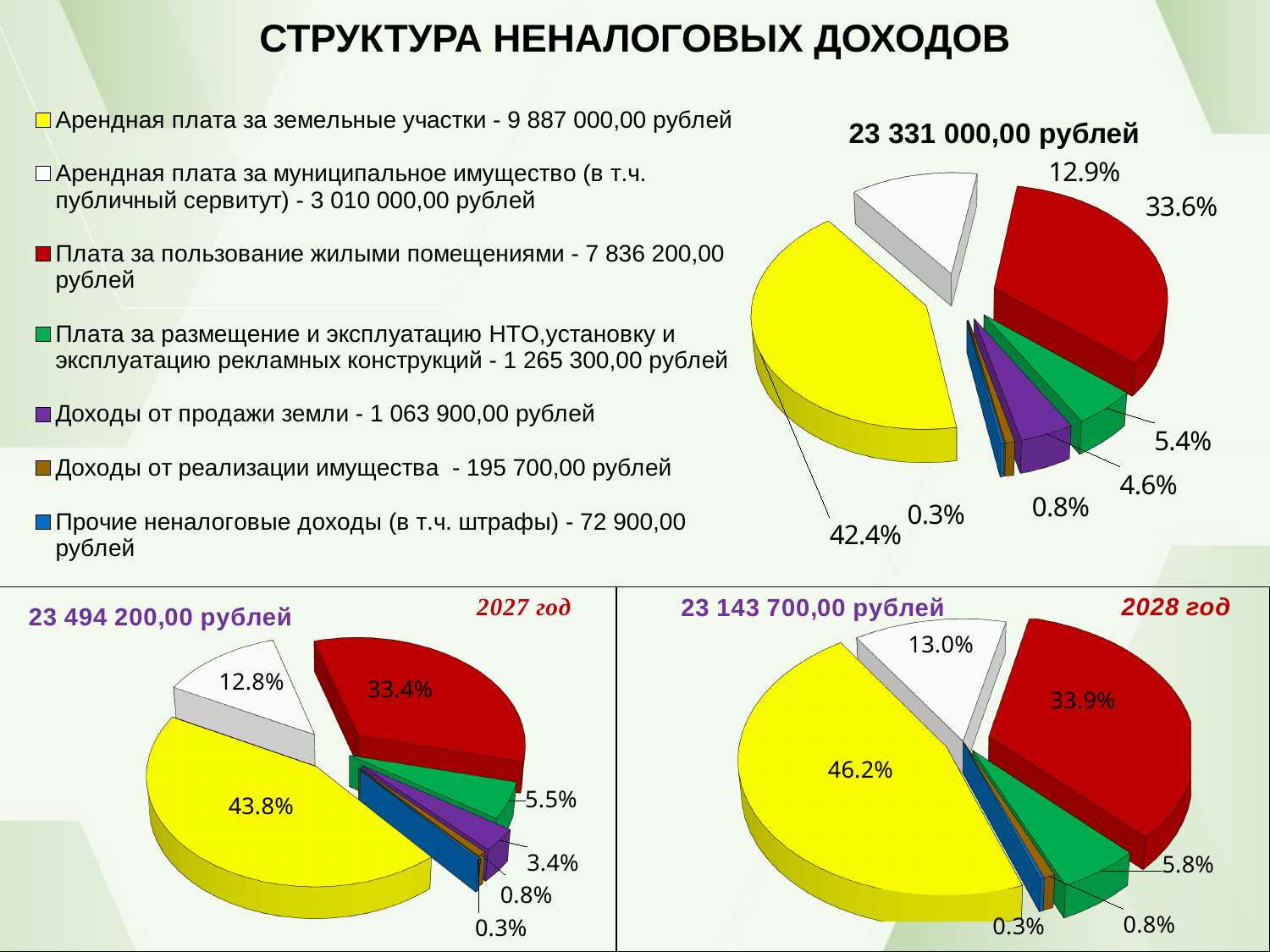
How many pie charts are on the slide? 3 In the top-right pie chart (23 331 000,00 рублей), which slice has the smallest share? Прочие неналоговые доходы (0.3%) How many categories does the legend list? 7 What total amount is shown above the 2028 год pie chart? 23 143 700,00 рублей In the top-right pie chart (23 331 000,00 рублей), what share is labelled for the yellow slice (Арендная плата за земельные участки)? 42.4% In the top-right pie chart (23 331 000,00 рублей), what share is labelled for the red slice (Плата за пользование жилыми помещениями)? 33.6% Which is larger: the green slice in the 2027 год chart or the green slice in the 2028 год chart? 2028 год (5.8%) In the 2028 год pie chart, what share is labelled for the white slice (Арендная плата за муниципальное имущество)? 13.0% What type of charts are shown on the slide? Pie charts In the 2027 год pie chart, what share is labelled for the largest slice? 43.8% In the 2028 год pie chart, what is the difference between the yellow slice (46.2%) and the red slice (33.9%)? 12.3%